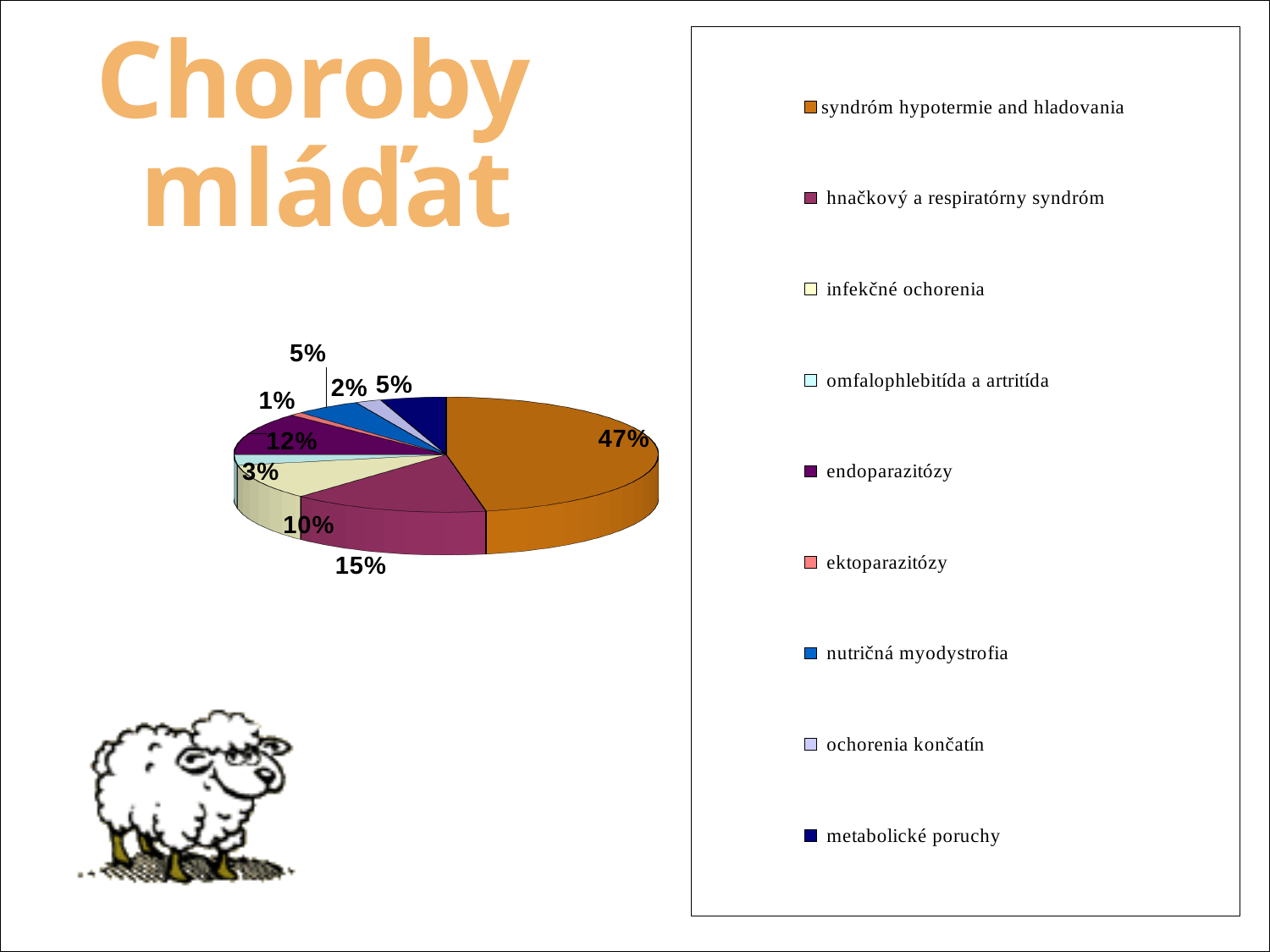
Which category has the largest slice of the pie? syndróm hypotermie and hladovania What kind of chart is shown on the slide? pie chart What share of the pie does 'infekčné ochorenia' have? 10% What share of the pie does 'ektoparazitózy' have? 1% What share of the pie does 'endoparazitózy' have? 12% What share of the pie does 'hnačkový a respiratórny syndróm' have? 15% What share of the pie does 'syndróm hypotermie and hladovania' have? 47% Which is larger, the slice for 'endoparazitózy' or the slice for 'infekčné ochorenia'? endoparazitózy How many categories does the legend list? 9 Which category has the smallest slice of the pie? ektoparazitózy What is the title of the slide containing the pie chart? Choroby mláďat What is the difference in percentage points between 'syndróm hypotermie and hladovania' and 'hnačkový a respiratórny syndróm'? 32